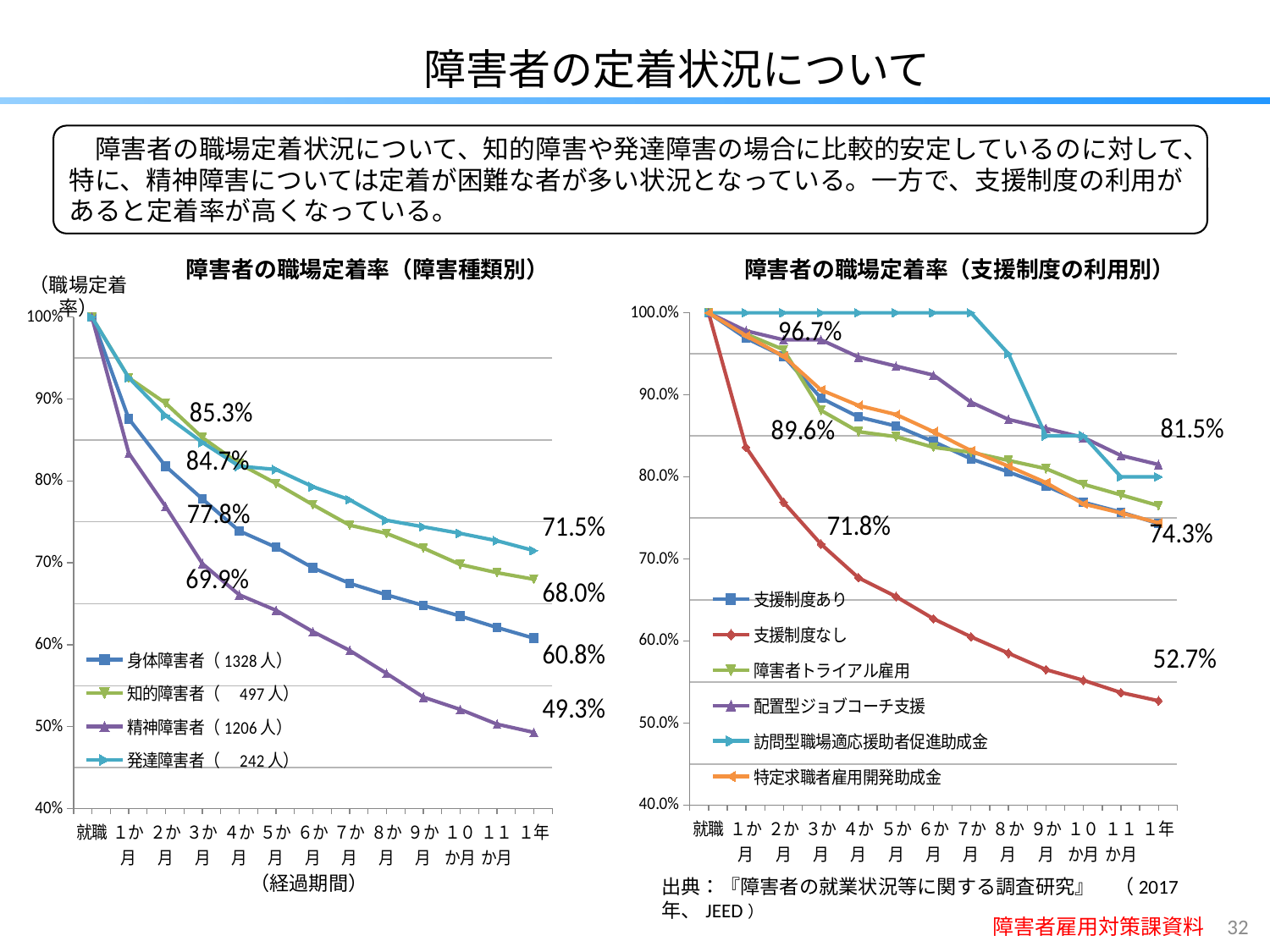
In the right chart (支援制度の利用別), which series has the highest retention rate at 1年? 配置型ジョブコーチ支援 In the left chart (障害種類別), what is the retention rate for 発達障害者 at 1年? 71.5% What kind of chart is the left chart, 障害者の職場定着率（障害種類別）? line chart In the right chart (支援制度の利用別), does the 支援制度なし line rise or fall from 就職 to 1年? fall In the right chart (支援制度の利用別), how many series does the legend list? 6 In the left chart (障害種類別), what is the retention rate for 身体障害者 at 1年? 60.8% In the left chart (障害種類別), how many series does the legend list? 4 In the left chart (障害種類別), which series has the lowest retention rate at 1年? 精神障害者 In the left chart (障害種類別), what is the retention rate for 精神障害者 at 1年? 49.3% In the left chart (障害種類別), how many time points are shown on the x axis? 13 In the left chart (障害種類別), what is the difference between the 1年 retention rates of 発達障害者 and 精神障害者? 22.2 percentage points In the right chart (支援制度の利用別), what is the retention rate for 支援制度なし at 1年? 52.7%